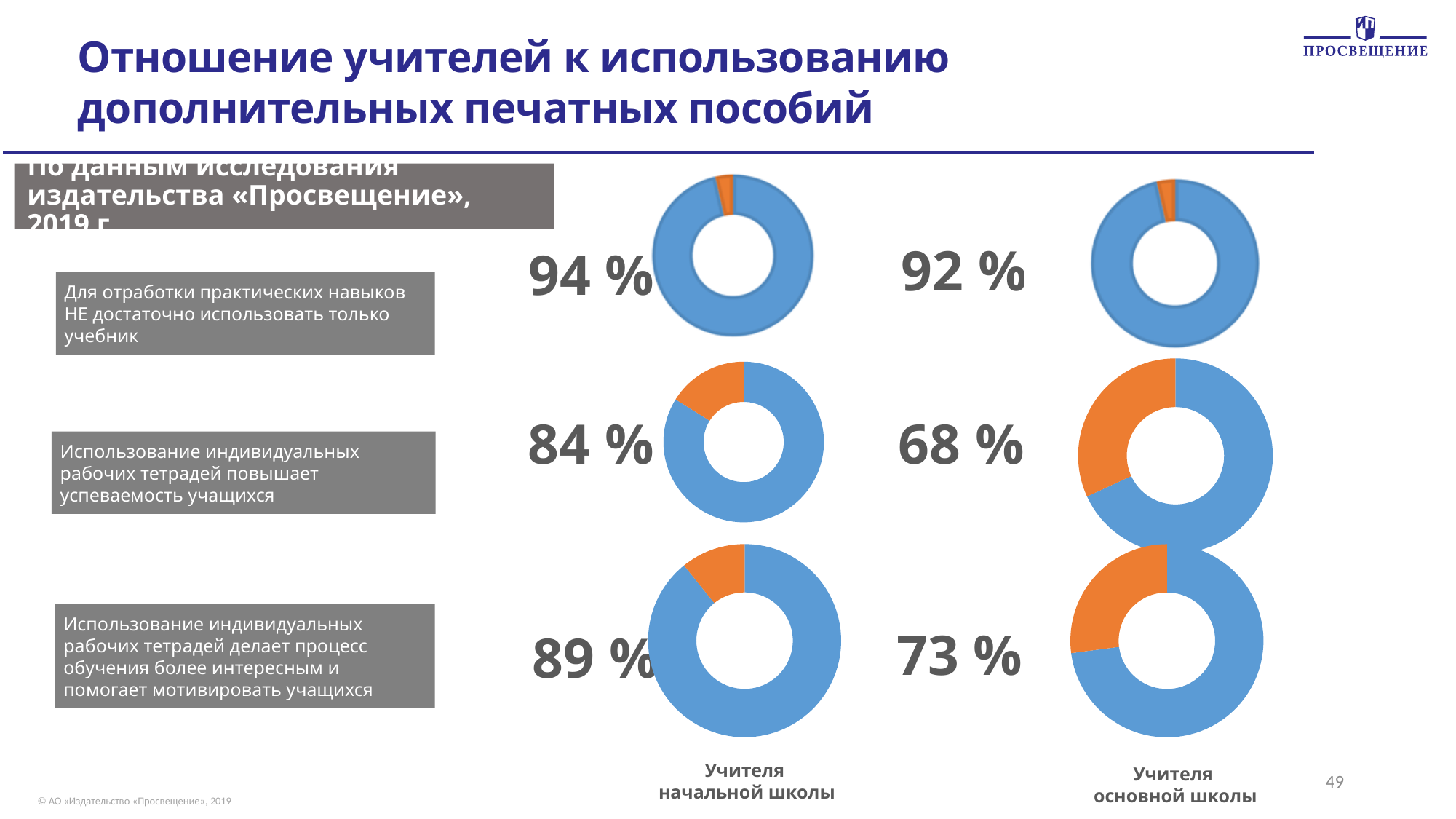
How many donut charts are shown on the slide? 6 In the bottom row (workbooks make learning more interesting and help motivate students), what value is shown for primary school teachers? 89 % What percentage of basic school teachers (Учителя основной школы) agree that the textbook alone is NOT enough to practise practical skills, according to the top-right donut chart? 92 % What is the difference between the primary school and basic school values in the bottom row (89 % vs 73 %)? 16 % Which group shows the higher value in the middle row: primary school teachers or basic school teachers? Primary school teachers (Учителя начальной школы) In the middle row (use of individual workbooks improves student performance), what value is shown for basic school teachers? 68 % What type of chart is used to display the percentages on this slide? Donut (pie) chart In the bottom row (workbooks make learning more interesting and help motivate students), what value is shown for basic school teachers? 73 % In the middle row (use of individual workbooks improves student performance), what value is shown for primary school teachers? 84 % What is the difference between the primary school and basic school values in the middle row (84 % vs 68 %)? 16 % What percentage of primary school teachers (Учителя начальной школы) agree that the textbook alone is NOT enough to practise practical skills, according to the top-left donut chart? 94 % Which of the six donut charts shows the lowest percentage? Basic school teachers, middle row (68 %)